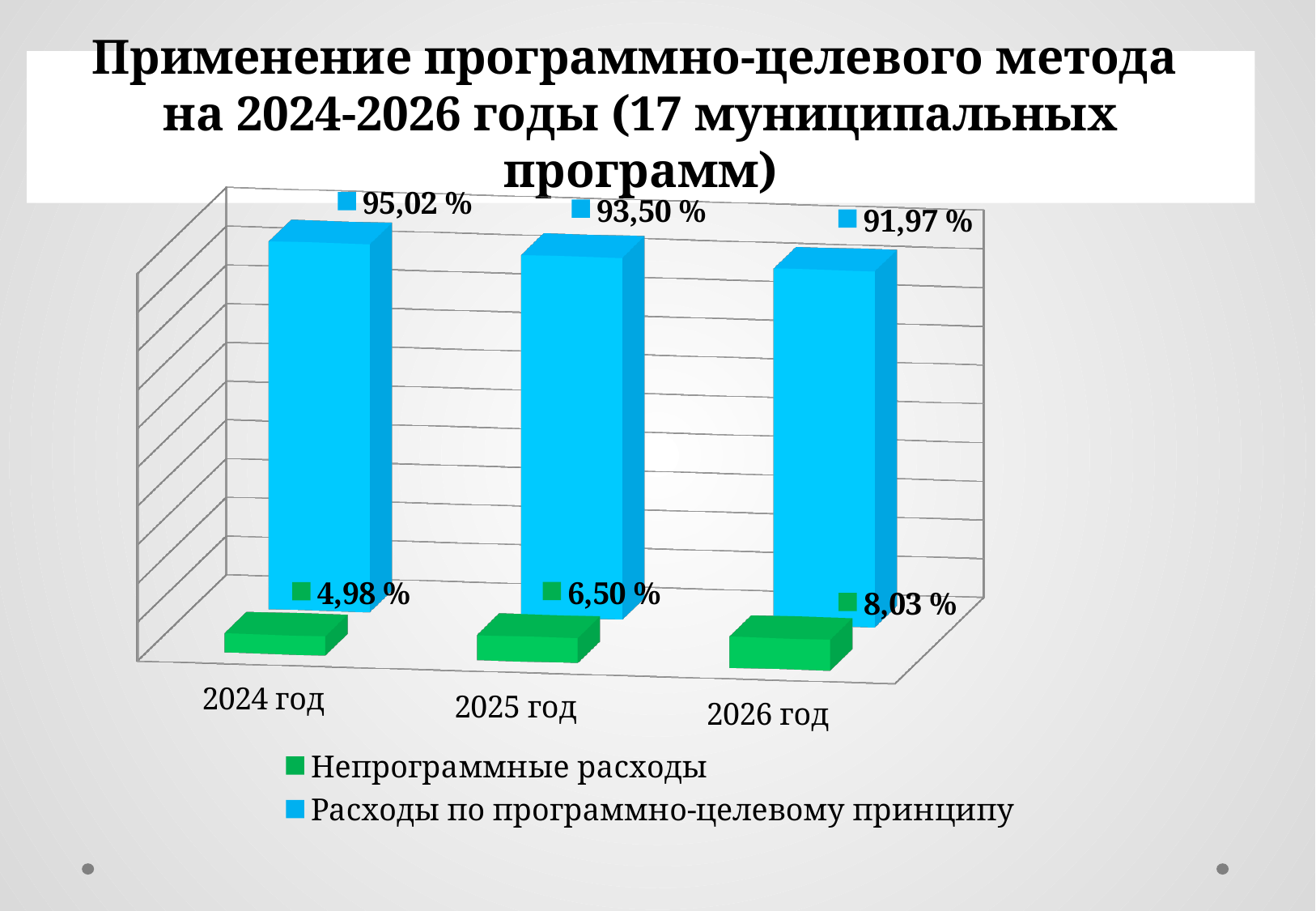
What is the value for Непрограммные расходы in 2025 год? 6,50 % Which colour represents Непрограммные расходы in the legend? Green Do the values for Расходы по программно-целевому принципу rise or fall from 2024 год to 2026 год? Fall What is the value for Расходы по программно-целевому принципу in 2024 год? 95,02 % In which year is Непрограммные расходы the highest? 2026 год In which year is Расходы по программно-целевому принципу the lowest? 2026 год What is the difference between Расходы по программно-целевому принципу in 2024 год and 2026 год? 3,05 % How many years are shown on the x axis? 3 How many series does the legend list? 2 What is the value for Непрограммные расходы in 2026 год? 8,03 % Which is larger: Непрограммные расходы in 2024 год or in 2025 год? 2025 год What kind of chart is shown on the slide? Bar chart